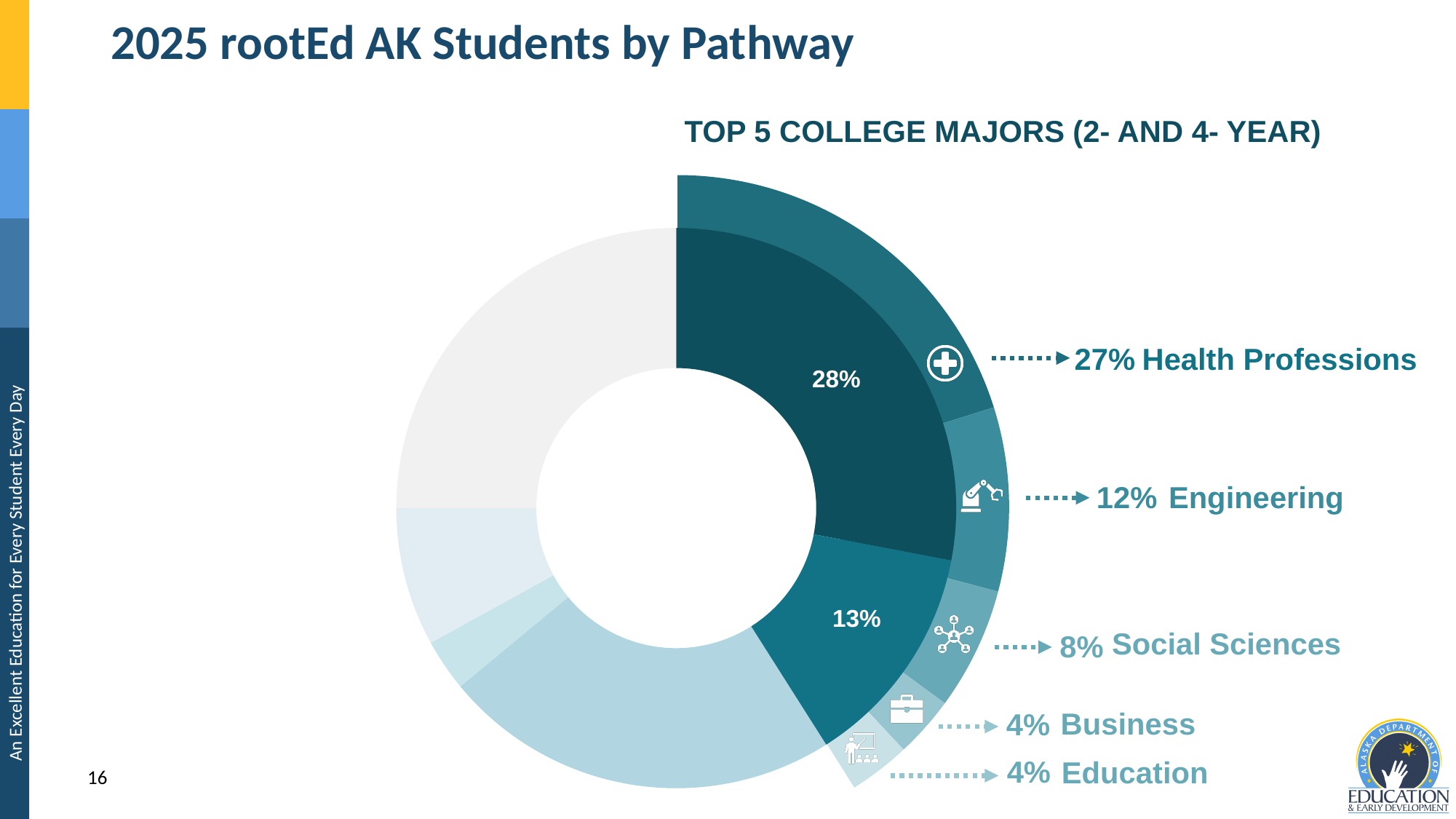
What percentage is shown for Business? 4% Which is larger, the percentage for Engineering or for Social Sciences? Engineering Which of the labelled college majors has the highest percentage? Health Professions What percentage is shown for Engineering? 12% What percentage is shown for Social Sciences? 8% How many college majors are labelled on the outer ring of the chart? 5 What kind of chart is shown on the slide? pie chart (donut) What percentage label is printed on the largest dark slice of the inner donut? 28% What is the combined percentage of the five labelled college majors? 55% What percentage is shown for Health Professions? 27% What is the difference in percentage points between Health Professions and Engineering? 15 What is the title of the chart? TOP 5 COLLEGE MAJORS (2- AND 4- YEAR)